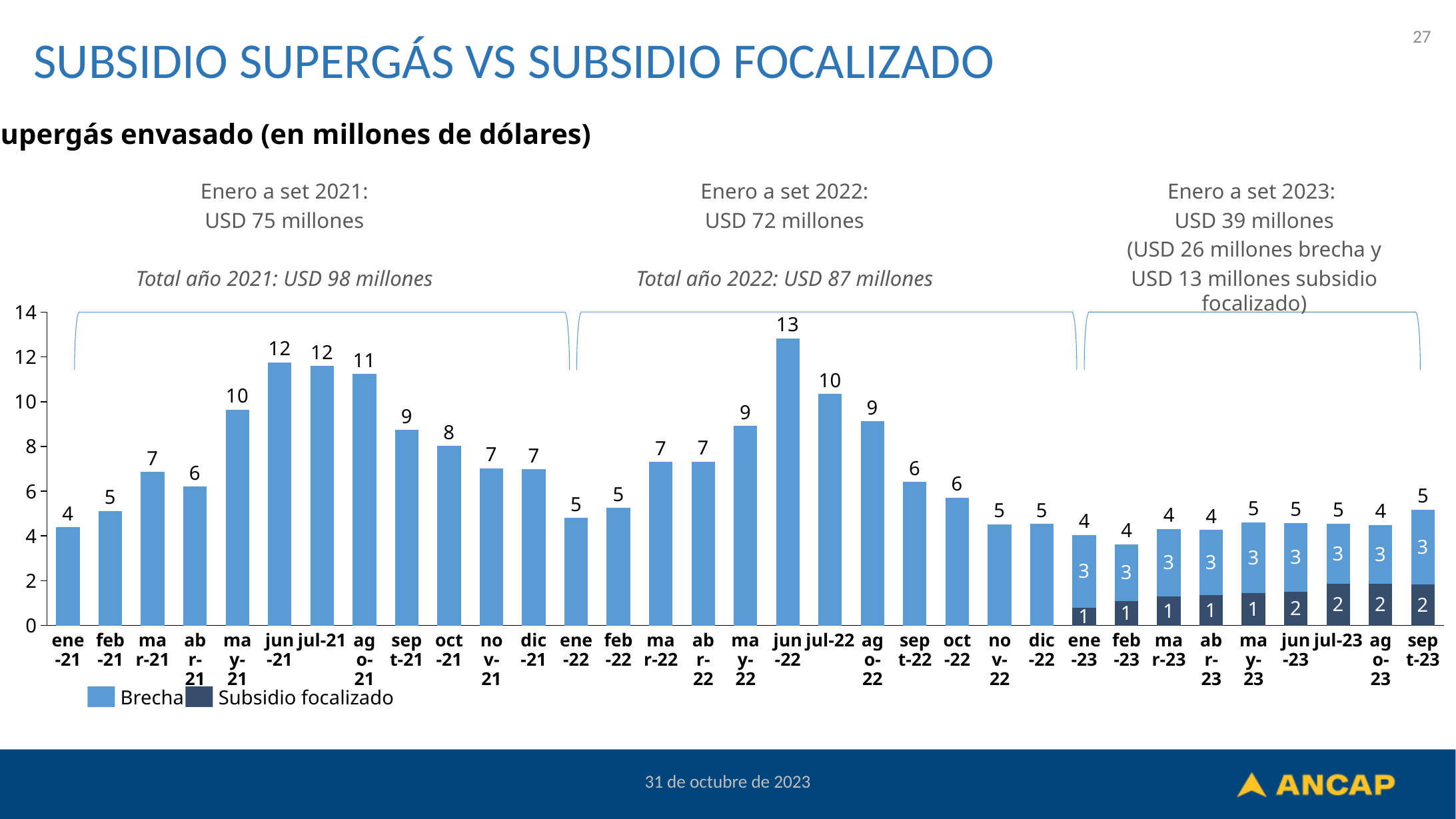
How many months are plotted on the x axis? 33 How many series does the legend list? 2 Is the value for jul-21 greater or less than 10? greater Which month has the highest value? jun-22 What is the Subsidio focalizado value for sep-23? 2 What is the value for may-21? 10 What is the Brecha value for ene-23? 3 Which is larger, the value for jun-21 or the value for jun-22? jun-22 What kind of chart is shown? bar chart What is the difference between the values for jun-22 and ene-21? 9 What is the value for jun-22? 13